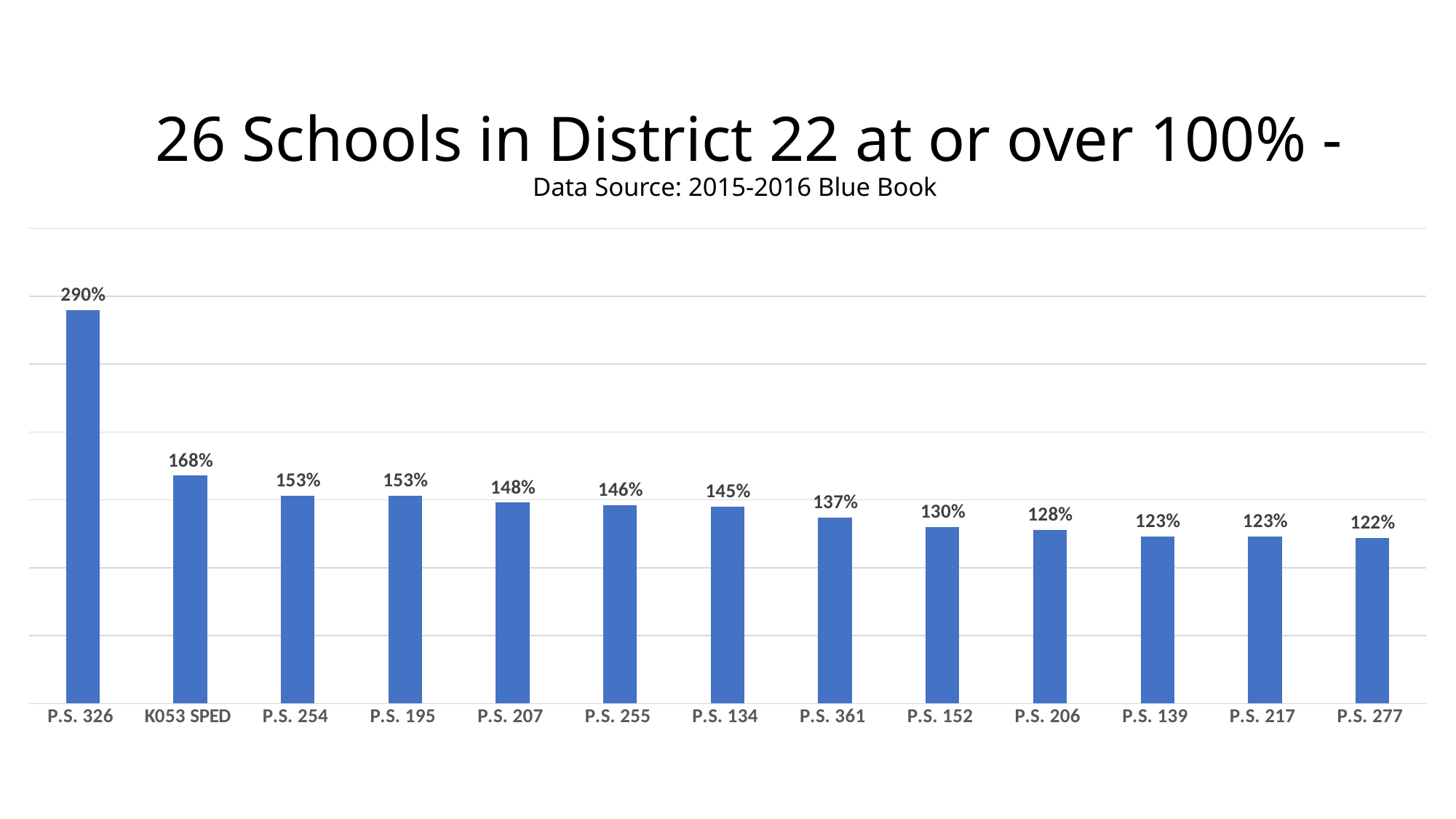
What is the difference between the values for P.S. 326 and K053 SPED? 122% What is the value for K053 SPED? 168% Do the values rise or fall from left to right along the x axis? Fall What is the value for P.S. 326? 290% Which school has the lowest value? P.S. 277 What is the value for P.S. 277? 122% What is the difference between the values for P.S. 207 and P.S. 152? 18% How many schools are shown on the chart? 13 What is the value for P.S. 361? 137% What kind of chart is shown on the slide? Bar chart Which school has the highest value? P.S. 326 Which is larger, the value for P.S. 255 or the value for P.S. 206? P.S. 255